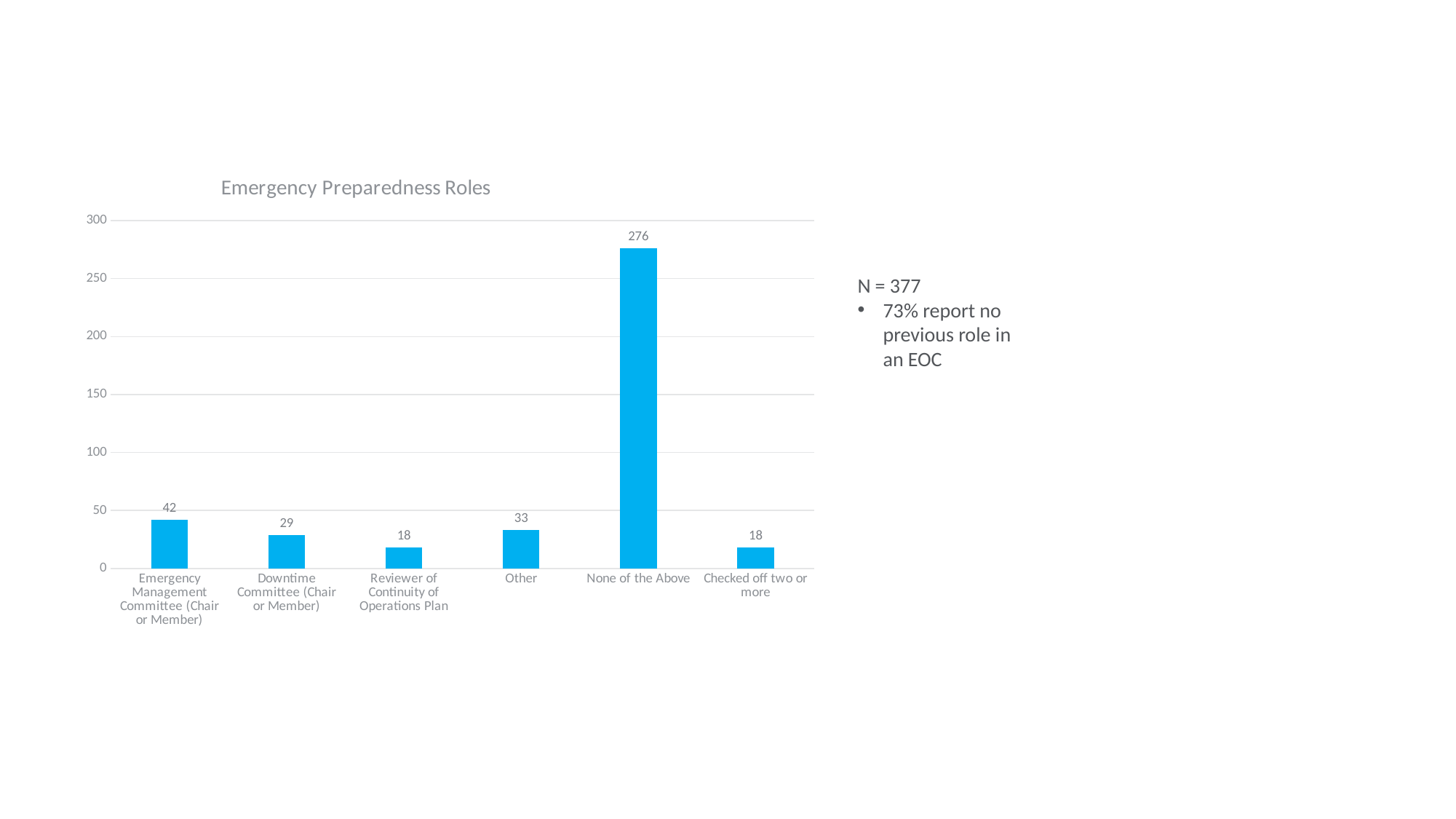
What is the value for Downtime Committee (Chair or Member)? 29 What is the title of the chart? Emergency Preparedness Roles What is the value for None of the Above? 276 Which is larger, Other or Downtime Committee (Chair or Member)? Other What is the difference between None of the Above and Emergency Management Committee (Chair or Member)? 234 Which category has the highest value? None of the Above How many categories are shown on the x axis? 6 What kind of chart is shown? bar chart Is the value for None of the Above greater or less than 250? greater What is the value for Emergency Management Committee (Chair or Member)? 42 What is the value for Other? 33 What is the difference between Emergency Management Committee (Chair or Member) and Downtime Committee (Chair or Member)? 13